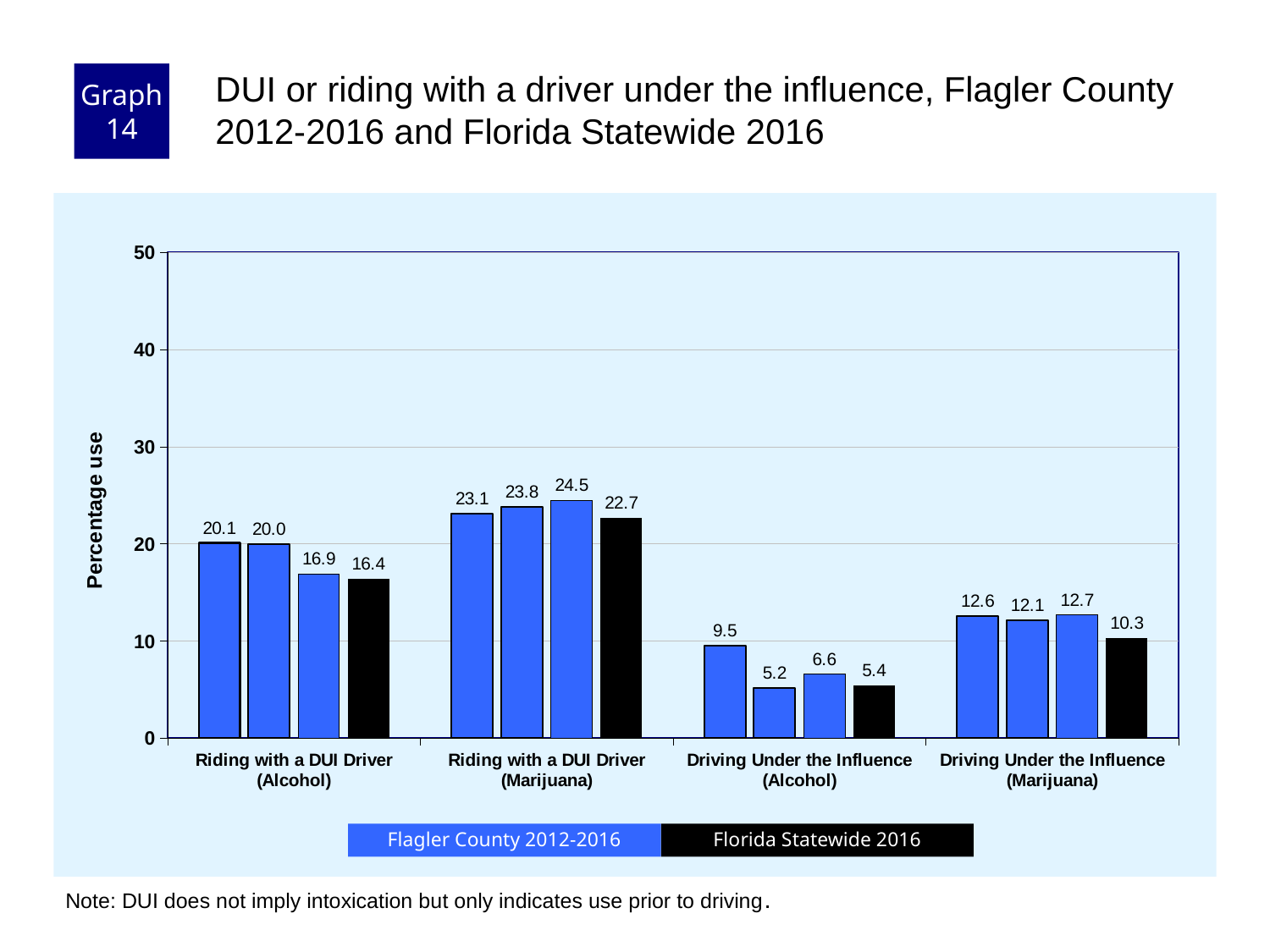
Is the Florida Statewide 2016 value for Riding with a DUI Driver (Marijuana) greater or less than 20? greater What is the difference between the Florida Statewide 2016 values for Riding with a DUI Driver (Marijuana) and Riding with a DUI Driver (Alcohol)? 6.3 What kind of chart is shown on the slide? bar chart What is the highest data label shown anywhere on the chart? 24.5 How many series does the legend list? 2 What is the highest value shown for any Flagler County 2012-2016 bar in the Driving Under the Influence (Alcohol) category? 9.5 What is the Florida Statewide 2016 value for Riding with a DUI Driver (Alcohol)? 16.4 How many categories are shown on the x axis? 4 What is the Florida Statewide 2016 value for Driving Under the Influence (Marijuana)? 10.3 Which is larger for Florida Statewide 2016: Riding with a DUI Driver (Alcohol) or Driving Under the Influence (Marijuana)? Riding with a DUI Driver (Alcohol) In which category is the Florida Statewide 2016 value lowest? Driving Under the Influence (Alcohol) In which category is the Florida Statewide 2016 value highest? Riding with a DUI Driver (Marijuana)